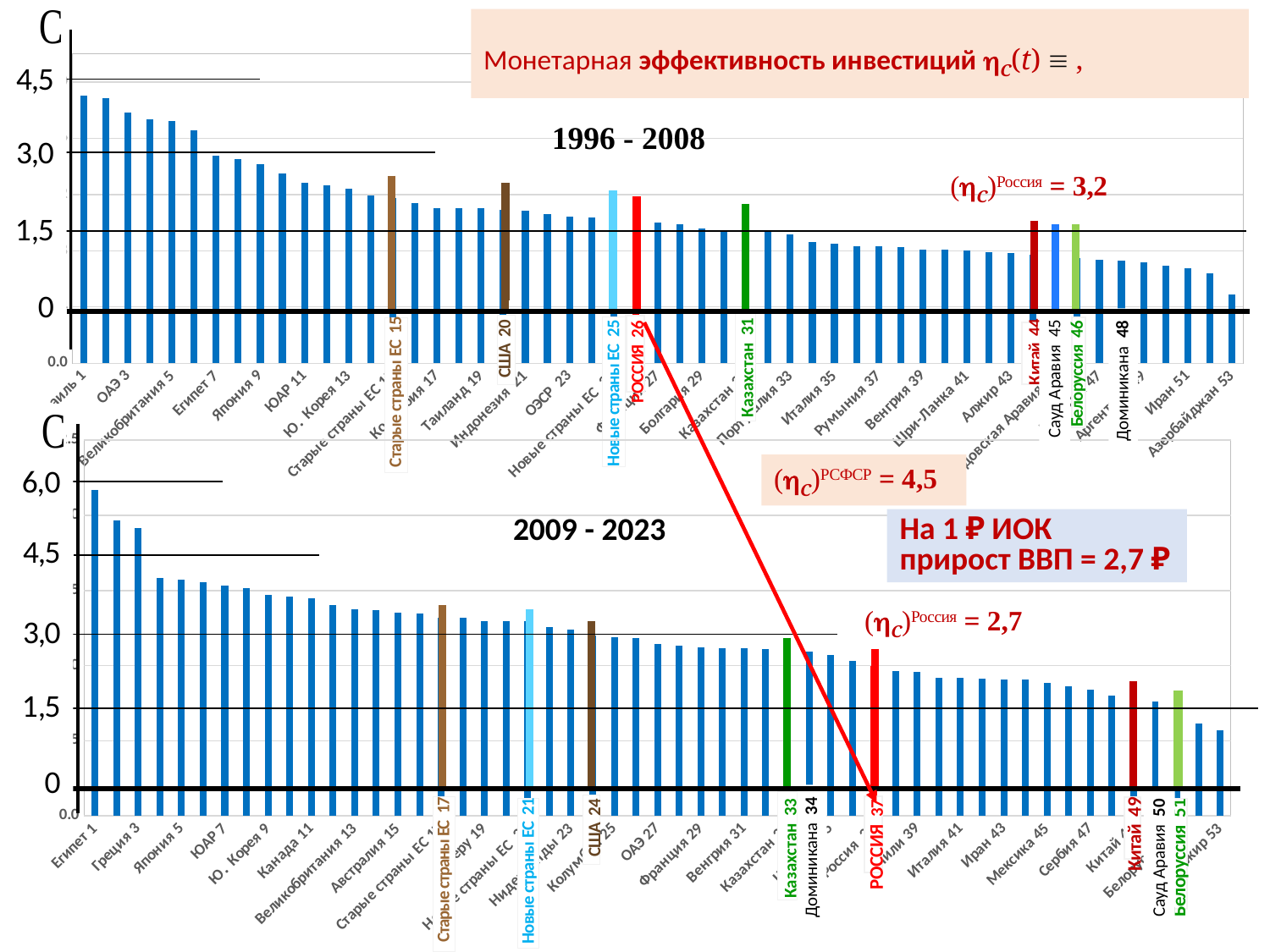
In the '2009 - 2023' chart, which category has the highest value? Египет 1 In the '2009 - 2023' chart, what is the value for РОССИЯ 37 according to the annotation on the slide? 2,7 How many categories are plotted in the '2009 - 2023' chart? 53 In the '1996 - 2008' chart, which category has the lowest value? Азербайджан 53 In the '2009 - 2023' chart, is the value for США 24 greater or less than 3,0? greater In the '2009 - 2023' chart, which is larger, the value for Старые страны ЕС 17 or the value for РОССИЯ 37? Старые страны ЕС 17 In the '1996 - 2008' chart, is the value for Казахстан 31 greater or less than 1,5? greater In the '2009 - 2023' chart, what colour is the bar for РОССИЯ 37? red What kind of chart is the '1996 - 2008' chart? bar chart In the '1996 - 2008' chart, do the values rise or fall from left to right along the x axis? fall In the '2009 - 2023' chart, is the value for Египет 1 greater or less than 4,5? greater